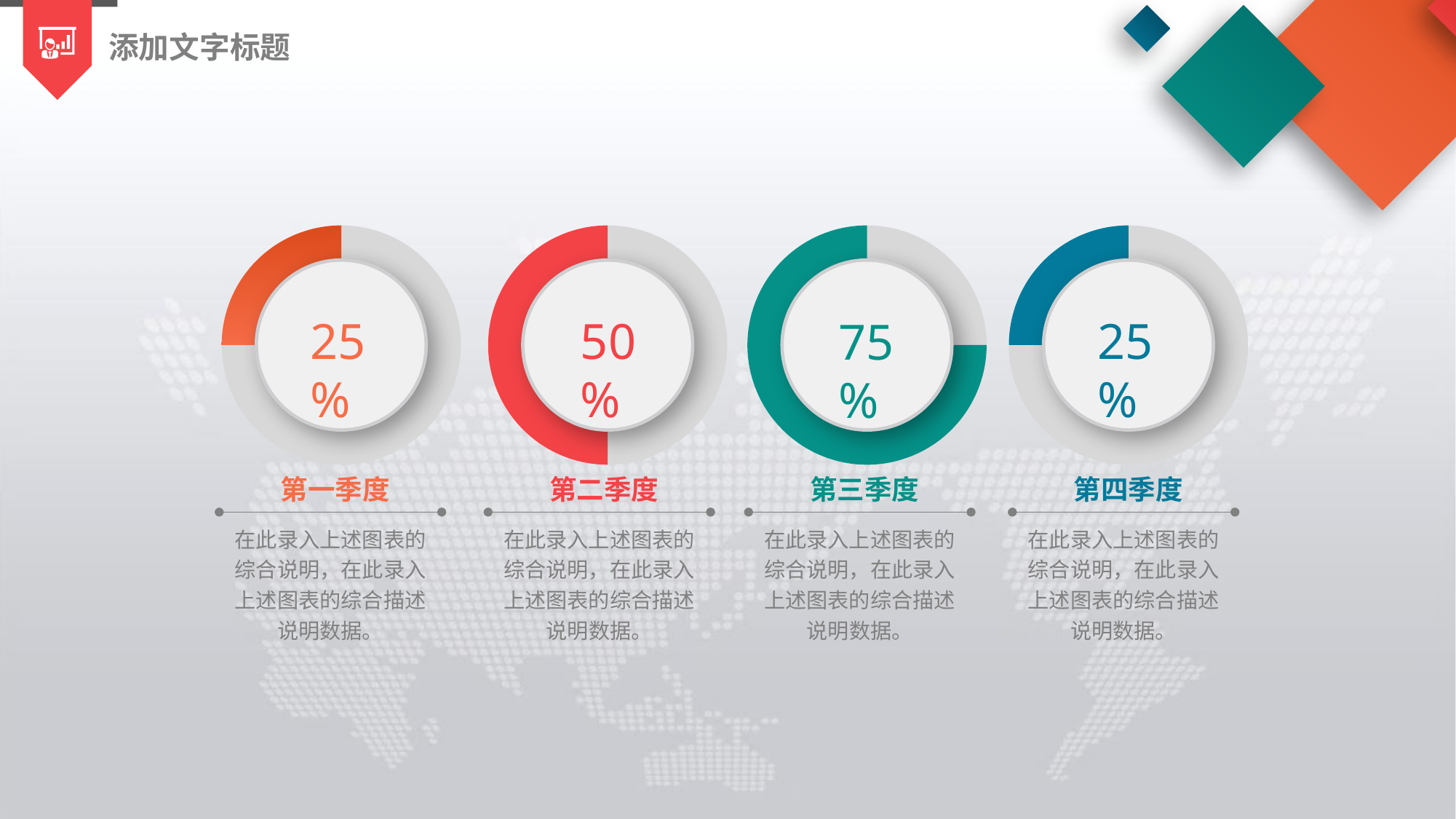
Which two quarters show the same percentage? 第一季度 and 第四季度 What is the difference between the percentages shown for 第三季度 and 第一季度? 50% What is the difference between the percentages shown for 第二季度 and 第四季度? 25% What value is shown in the 第三季度 ring chart? 75% What value is shown in the 第四季度 ring chart? 25% How many ring charts are shown on the slide? 4 Which is larger, the percentage for 第二季度 or the percentage for 第四季度? 第二季度 What value is shown in the 第二季度 ring chart? 50% Across the four ring charts, which quarter shows the highest percentage? 第三季度 What value is shown in the 第一季度 ring chart? 25% What kind of chart is used to display each quarter's percentage? Ring (donut) chart What colour is the filled portion of the 第三季度 ring chart? Green